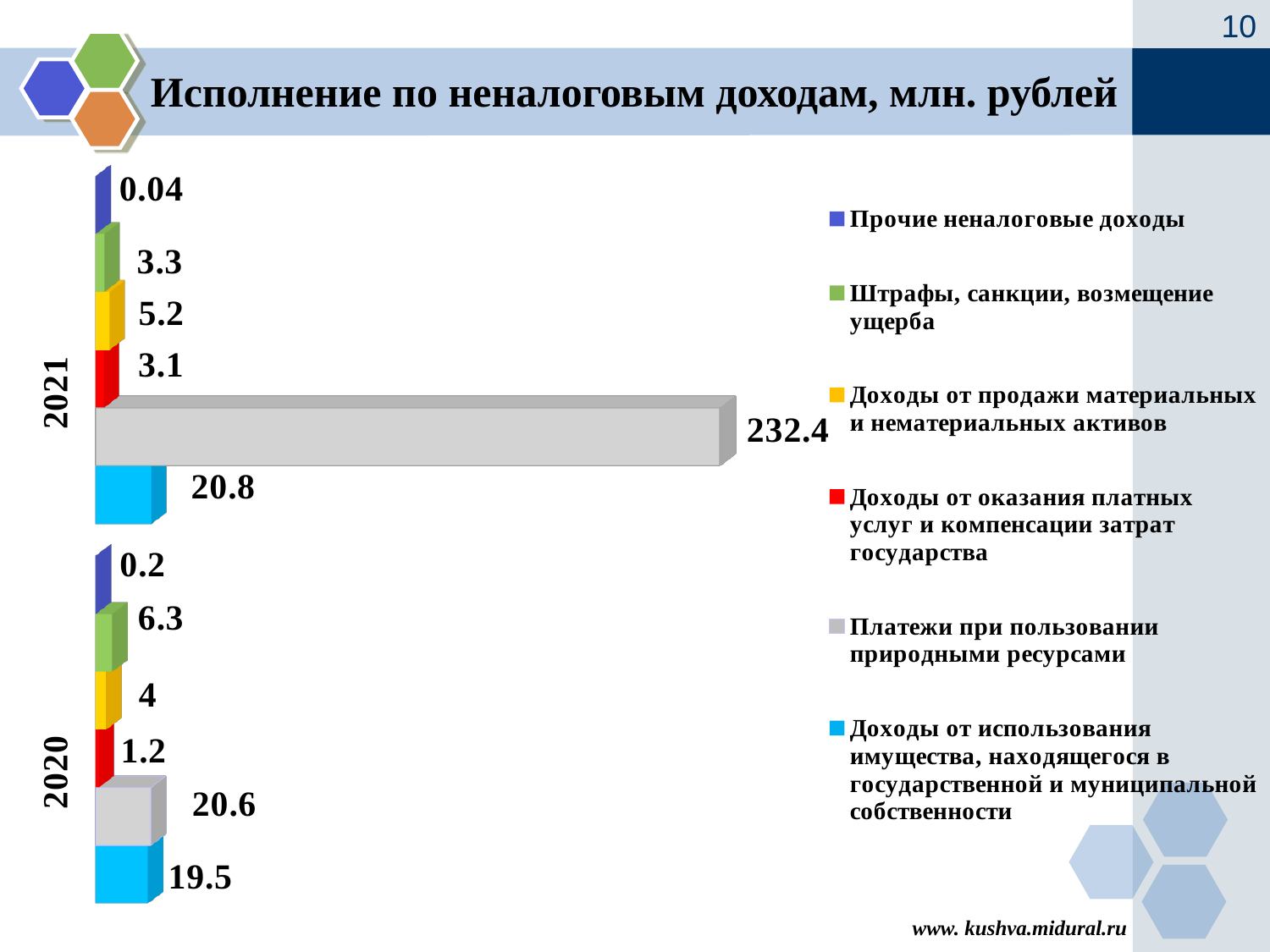
What is the value for 'Прочие неналоговые доходы' in 2020? 0.2 What is the value for 'Штрафы, санкции, возмещение ущерба' in 2021? 3.3 How many year categories are shown on the chart? 2 Which series has the highest value in 2021? Платежи при пользовании природными ресурсами What kind of chart is shown on the slide? Bar chart What is the title of the chart? Исполнение по неналоговым доходам, млн. рублей What is the difference between the 2021 and 2020 values for 'Платежи при пользовании природными ресурсами'? 211.8 What is the value for 'Платежи при пользовании природными ресурсами' in 2021? 232.4 What is the value for 'Доходы от использования имущества, находящегося в государственной и муниципальной собственности' in 2020? 19.5 Which is larger: 'Доходы от продажи материальных и нематериальных активов' in 2021 or in 2020? 2021 Which series has the lowest value in 2020? Прочие неналоговые доходы How many series does the legend list? 6